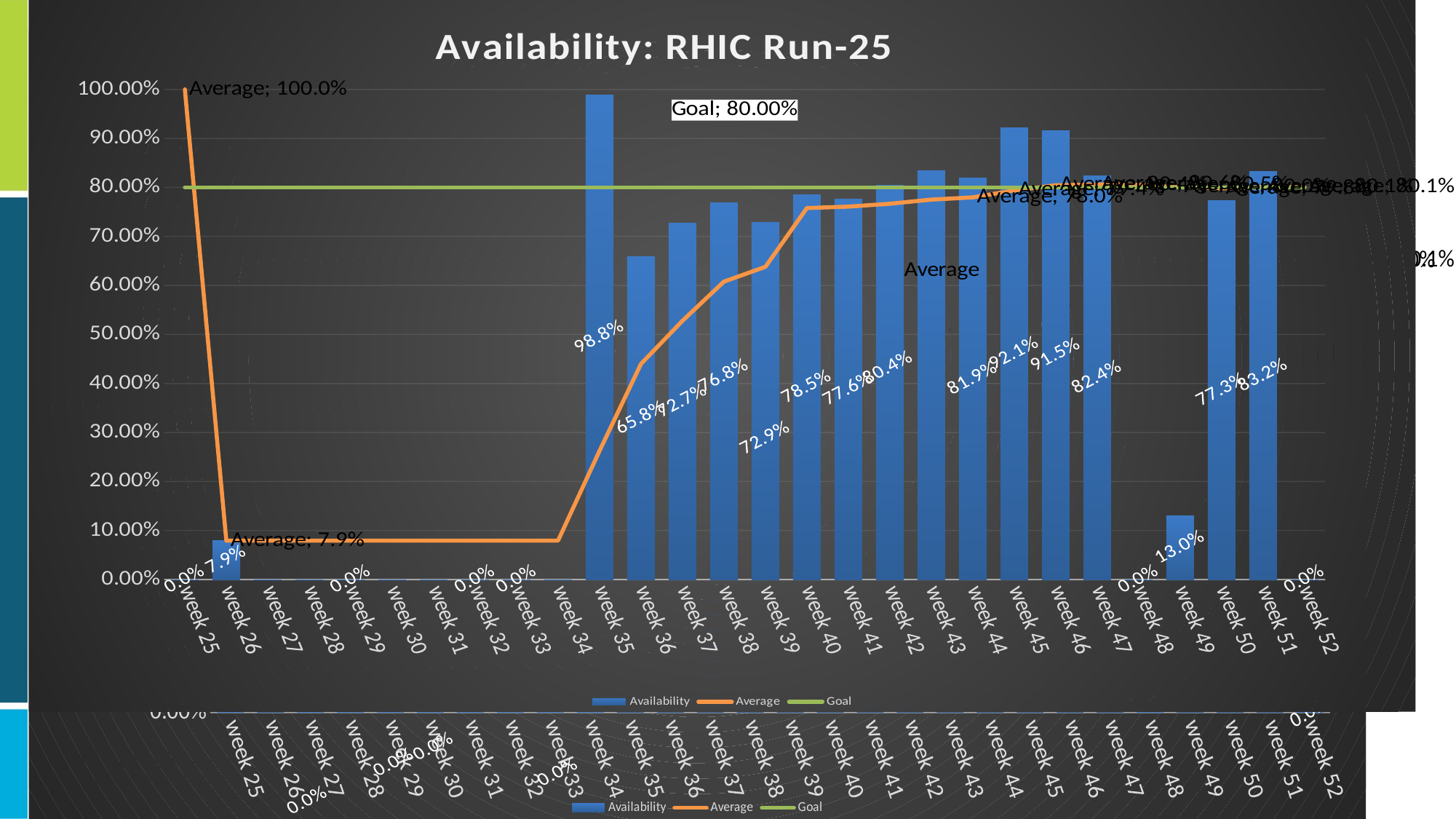
How many series does the chart legend list? 3 What is the value of the Goal line? 80.00% What is the title of the chart? Availability: RHIC Run-25 What kind of chart is used to show the Availability series? Bar chart What is the Availability value for week 35? 98.8% Which is larger, the Availability value for week 35 or for week 36? week 35 Which week has the highest Availability value? week 35 How many weeks are shown on the x axis? 28 What is the Availability value for week 26? 7.9% What is the difference between the Availability values for week 35 and week 36? 33.0% What is the Availability value for week 36? 65.8% Is the Availability value for week 39 greater or less than 80.00%? less